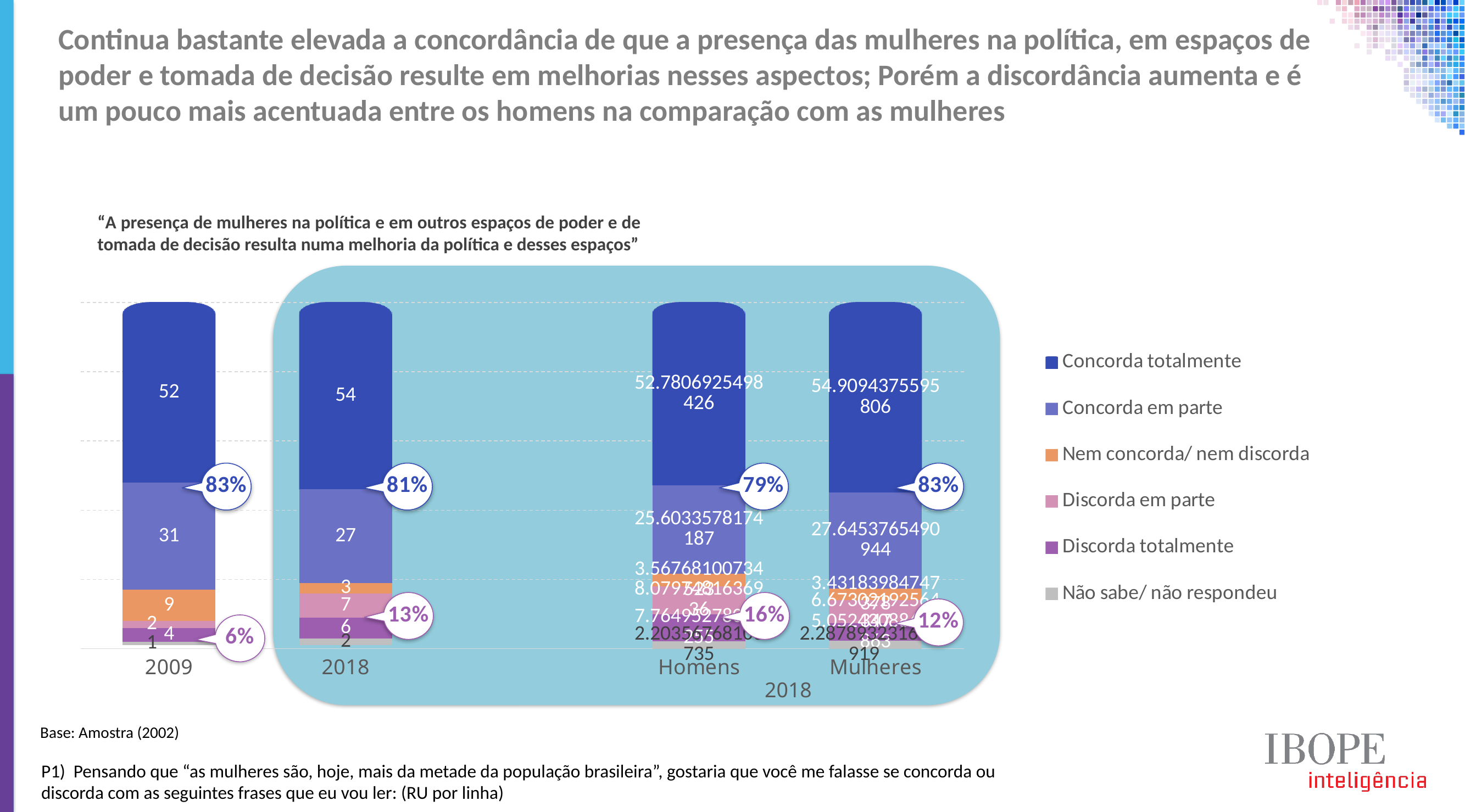
Which legend entry is shown in orange? Nem concorda/ nem discorda What is the value for "Concorda em parte" in the 2018 bar? 27 What kind of chart is shown on the slide? stacked bar chart How many bars are plotted in the chart? 4 What is the value for "Concorda totalmente" in the 2009 bar? 52 What percentage is shown in the callout for total disagreement in the Mulheres bar? 12% How many series does the legend list? 6 What is the value for "Discorda em parte" in the 2018 bar? 7 Which is larger, the "Concorda em parte" value for 2009 or for 2018? 2009 What is the value for "Nem concorda/ nem discorda" in the 2009 bar? 9 What is the difference between the "Concorda totalmente" values for 2018 and 2009? 2 What percentage is shown in the callout for total agreement in the Homens bar? 79%